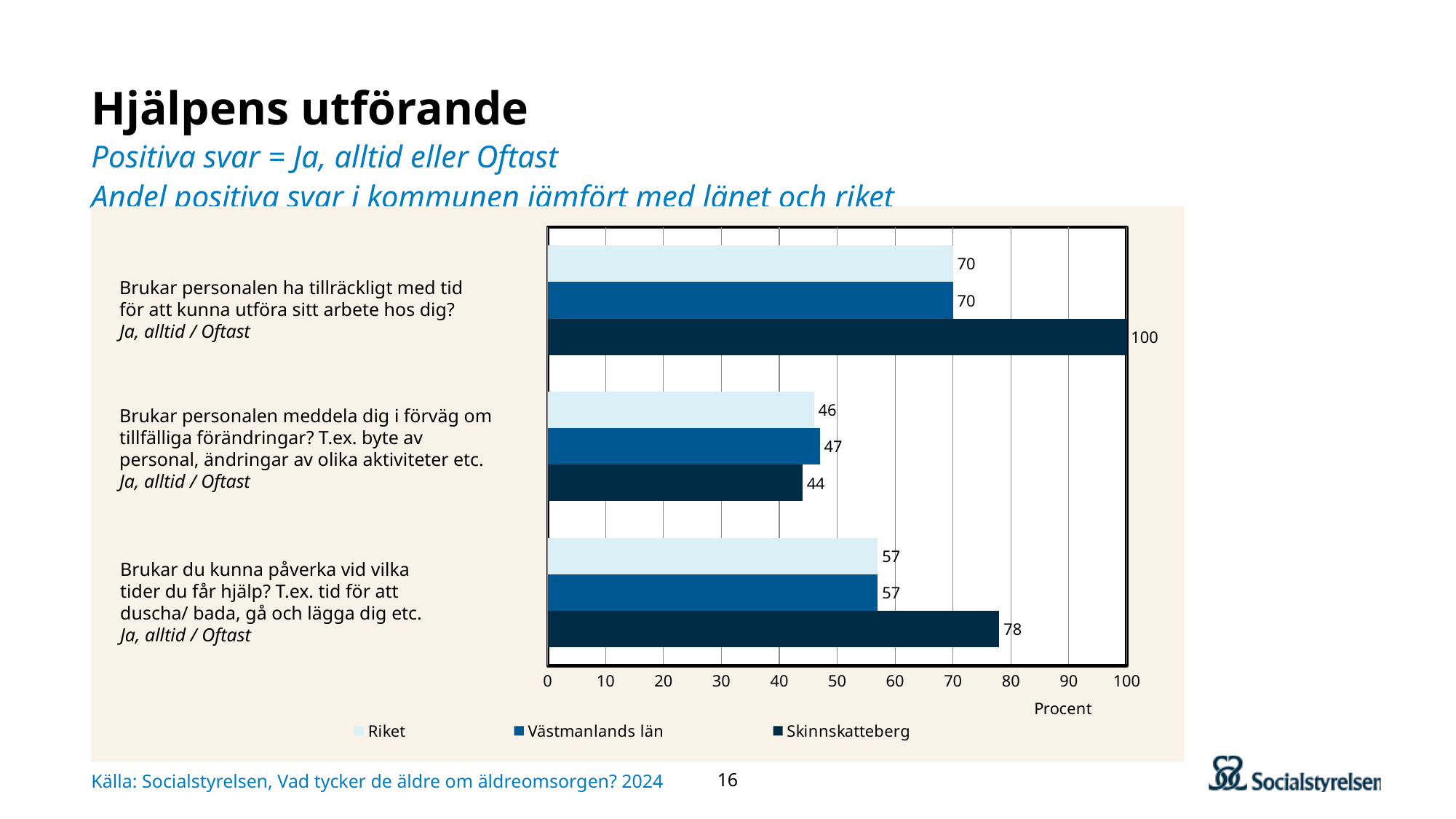
How many question categories are plotted on the chart? 3 What is the value for Riket on the question 'Brukar personalen meddela dig i förväg om tillfälliga förändringar?' 46 Which series has the highest value on the question 'Brukar du kunna påverka vid vilka tider du får hjälp?' Skinnskatteberg Which series has the lowest value on the question 'Brukar personalen meddela dig i förväg om tillfälliga förändringar?' Skinnskatteberg What unit is shown on the x axis of the chart? Procent What is the value for Västmanlands län on the question 'Brukar du kunna påverka vid vilka tider du får hjälp?' 57 Is the value for Skinnskatteberg on the question 'Brukar personalen ha tillräckligt med tid för att kunna utföra sitt arbete hos dig?' greater or less than 90? greater What is the value for Skinnskatteberg on the question 'Brukar personalen ha tillräckligt med tid för att kunna utföra sitt arbete hos dig?' 100 Which is larger on the question 'Brukar personalen meddela dig i förväg om tillfälliga förändringar?': Västmanlands län or Skinnskatteberg? Västmanlands län How many series does the legend list? 3 What is the difference between Skinnskatteberg and Riket on the question 'Brukar du kunna påverka vid vilka tider du får hjälp?' 21 What type of chart is shown on the slide? Bar chart